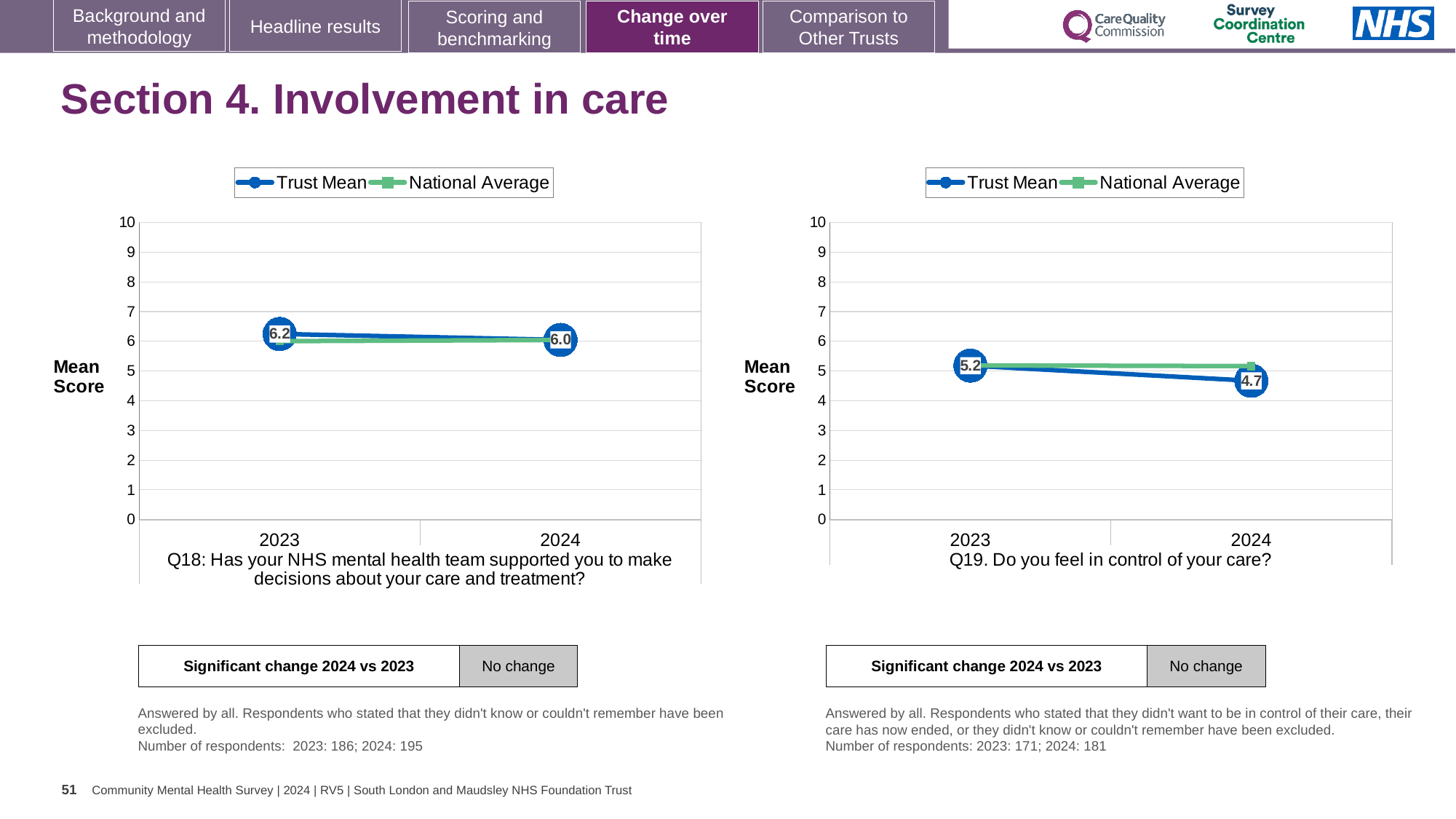
In the Q19 chart, by how much did the Trust Mean fall from 2023 to 2024? 0.5 In the Q19 chart, is the National Average for 2024 greater or less than 4? greater In the Q18 chart, what is the Trust Mean for 2024? 6.0 In the Q19 chart, which is larger in 2024, the Trust Mean or the National Average? National Average How many years are plotted on the x axis of the Q18 chart? 2 In the Q18 chart, what is the Trust Mean for 2023? 6.2 In the Q19 chart, what is the Trust Mean for 2023? 5.2 In the Q19 chart, what is the Trust Mean for 2024? 4.7 How many series does the legend of the Q19 chart list? 2 In the Q18 chart, what is the difference between the Trust Mean in 2023 and in 2024? 0.2 In the Q19 chart, does the Trust Mean rise or fall from 2023 to 2024? fall What kind of chart is used for Q18? line chart